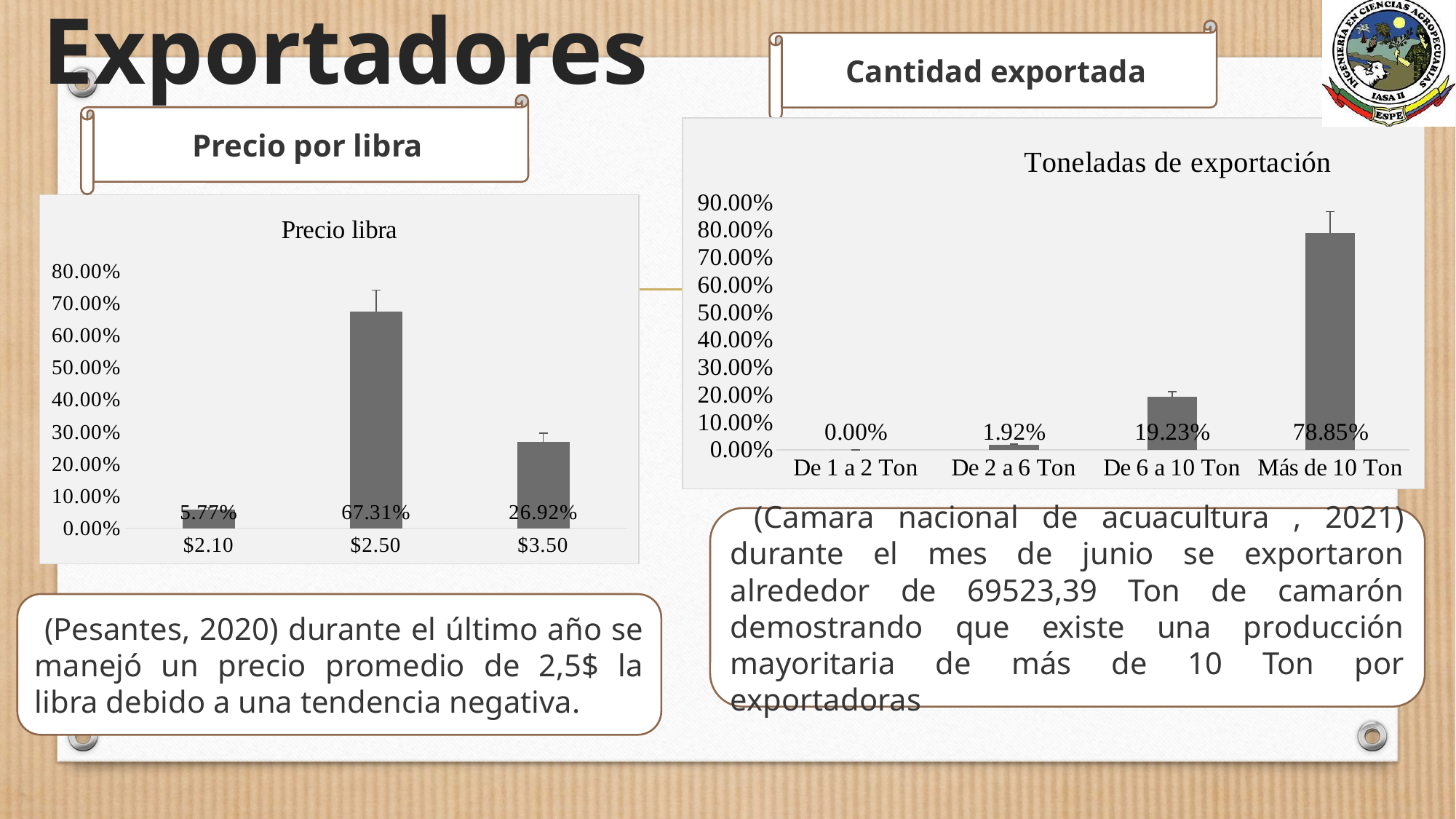
In the 'Precio libra' chart, how many price categories are shown? 3 In the 'Toneladas de exportación' chart, is the value for 'De 2 a 6 Ton' larger or smaller than the value for 'De 6 a 10 Ton'? smaller In the 'Precio libra' chart, what is the value for $2.10? 5.77% In the 'Precio libra' chart, which price category has the highest value? $2.50 In the 'Toneladas de exportación' chart, what is the value for 'De 6 a 10 Ton'? 19.23% In the 'Toneladas de exportación' chart, what is the value for 'Más de 10 Ton'? 78.85% In the 'Precio libra' chart, which price category has the lowest value? $2.10 In the 'Precio libra' chart, what is the value for $2.50? 67.31% In the 'Toneladas de exportación' chart, do the values rise or fall from left to right along the x axis? rise What kind of chart is the 'Toneladas de exportación' chart? bar chart In the 'Toneladas de exportación' chart, which category has the lowest value? De 1 a 2 Ton In the 'Precio libra' chart, what is the difference between the values for $2.50 and $3.50? 40.39%